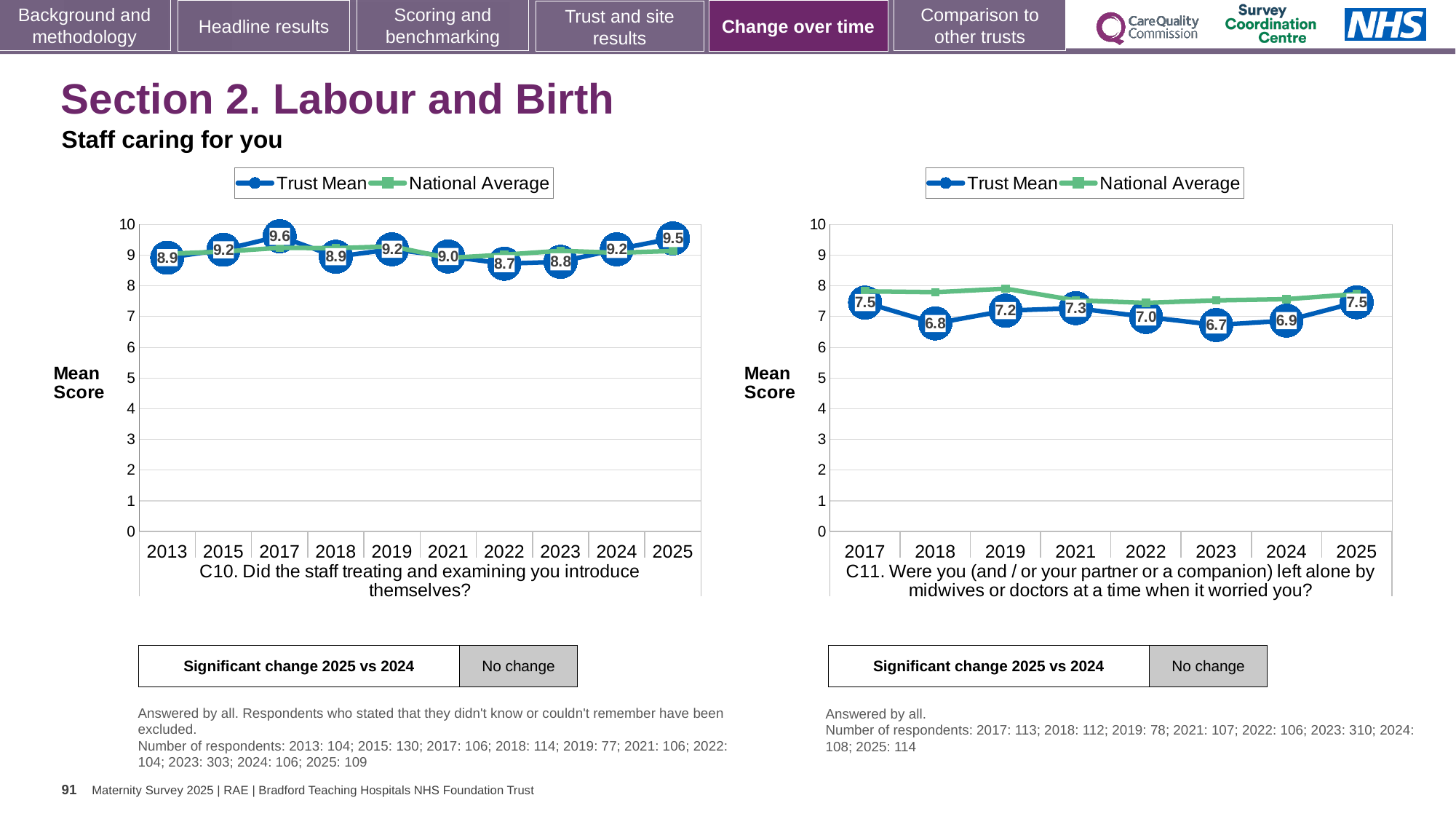
In the C10 chart, what is the difference between the Trust Mean for 2025 and for 2024? 0.3 What kind of chart is the C10 chart? Line chart In the C10 chart, which year has the highest Trust Mean? 2017 In the C10 chart, what is the Trust Mean for 2022? 8.7 In the C11 chart, which year has the lowest Trust Mean? 2023 In the C11 chart, is the National Average for 2019 greater or less than 7? greater In the C11 chart, is the Trust Mean for 2017 or for 2022 larger? 2017 In the C11 chart, what is the Trust Mean for 2018? 6.8 In the C10 chart, how many years are shown on the x axis? 10 In the C10 chart, what is the Trust Mean for 2017? 9.6 In the C10 chart, which year has the lowest Trust Mean? 2022 How many series does the legend of the C11 chart list? 2